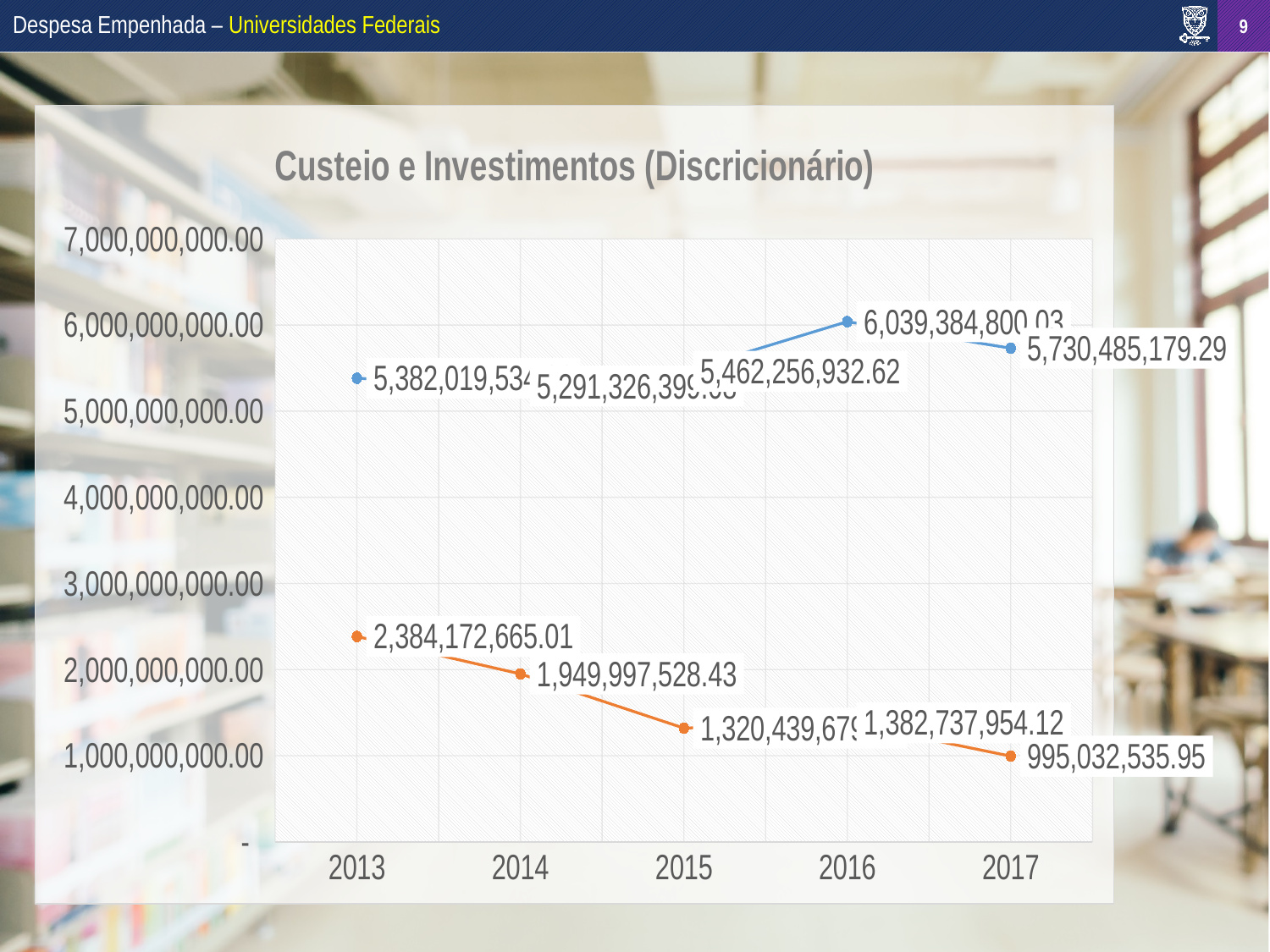
What is the value of the orange series in 2017? 995,032,535.95 In which year does the orange series reach its lowest value? 2017 What is the title of the chart? Custeio e Investimentos (Discricionário) What is the value of the orange series in 2013? 2,384,172,665.01 What type of chart is shown on the slide? line chart What is the value of the blue series in 2015? 5,462,256,932.62 Is the value of the orange series in 2015 greater or less than 1,000,000,000.00? greater In which year does the blue series reach its highest value? 2016 What is the difference between the orange series values in 2013 and 2014? 434,175,136.58 How many years are plotted along the x axis? 5 What is the value of the blue series in 2017? 5,730,485,179.29 What is the value of the orange series in 2014? 1,949,997,528.43